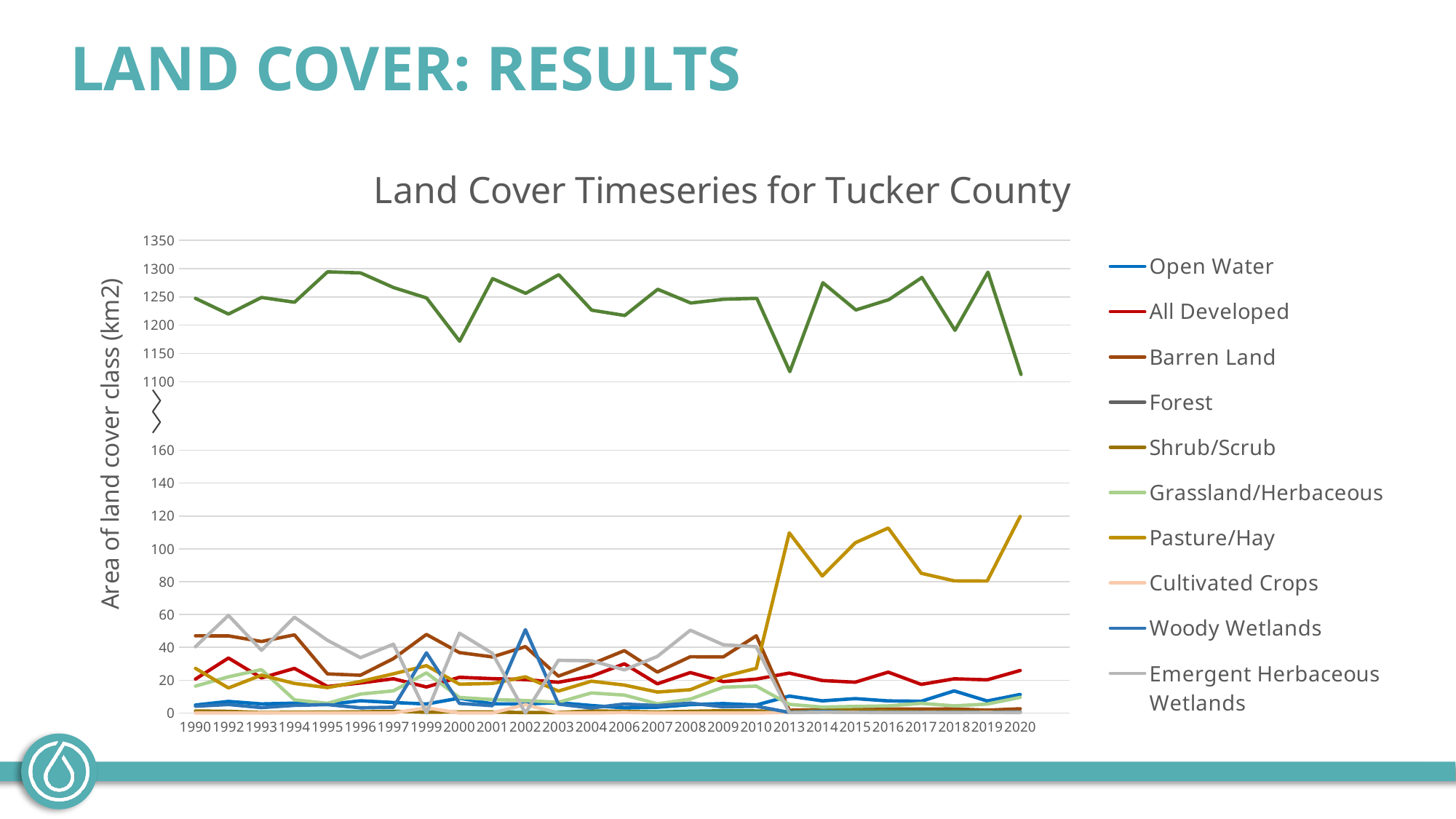
How many years are plotted along the x axis of the chart? 26 Is the value for Pasture/Hay in 2010 greater or less than 40? less How many series does the chart's legend list? 10 In which year does the Pasture/Hay series reach its highest value? 2020 What kind of chart is shown on the slide? line chart What is the title of the chart? Land Cover Timeseries for Tucker County What is the label of the vertical axis of the chart? Area of land cover class (km2) Is the value for Woody Wetlands in 2002 greater or less than 40? greater Is the value for Emergent Herbaceous Wetlands in 1992 greater or less than 40? greater Which is larger, the Pasture/Hay value in 2013 or in 2014? 2013